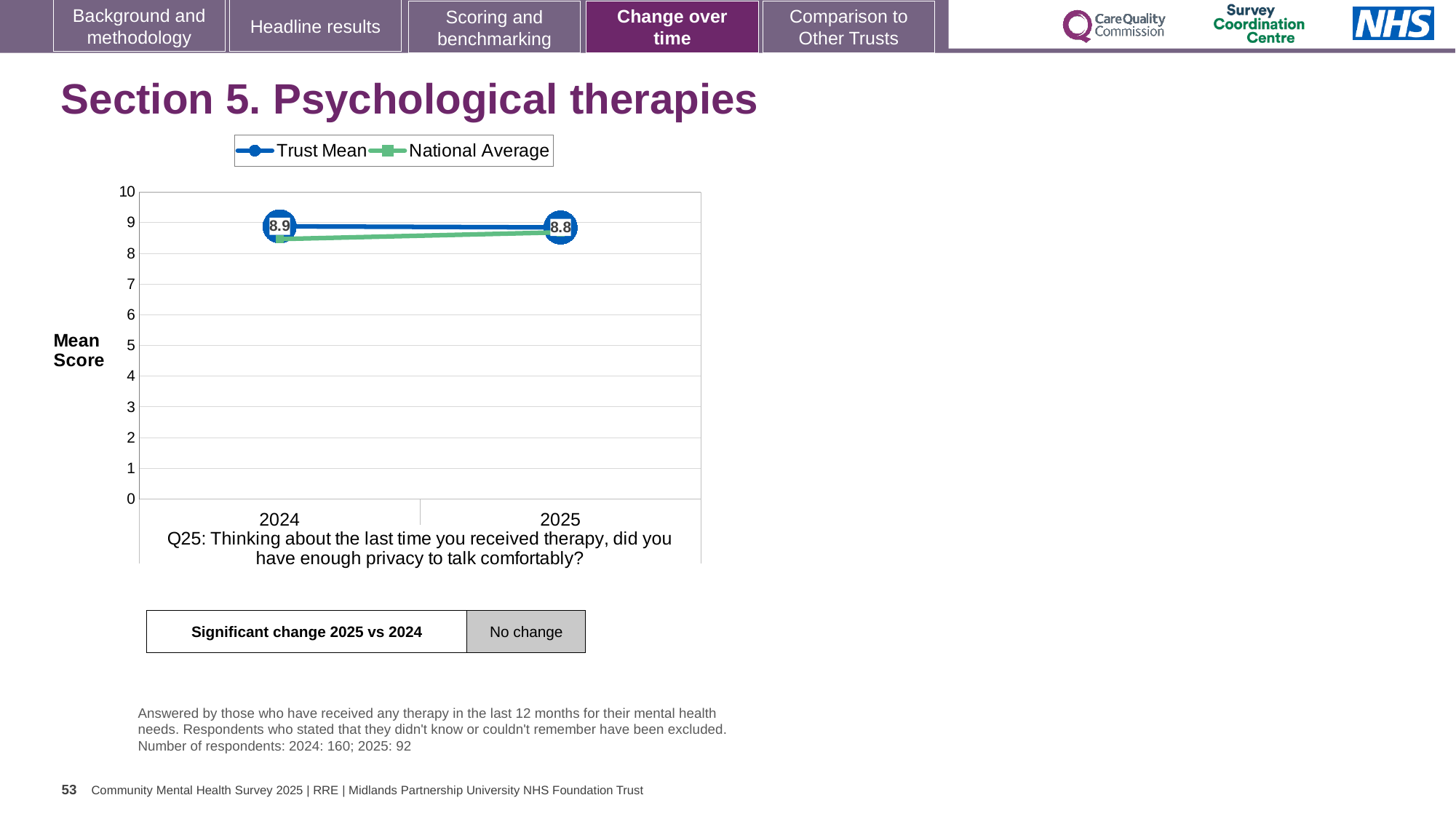
Is the National Average for 2024 greater or less than 8? greater What is the Trust Mean score for 2025? 8.8 In 2024, which is higher: the Trust Mean or the National Average? Trust Mean Is the National Average for 2024 greater or less than 9? less By how much did the Trust Mean change from 2024 to 2025? 0.1 What kind of chart is shown on the slide? line chart Does the Trust Mean rise or fall from 2024 to 2025? fall How many years are plotted on the x axis? 2 In which year is the Trust Mean higher? 2024 Does the National Average rise or fall from 2024 to 2025? rise How many series does the legend list? 2 What is the Trust Mean score for 2024? 8.9